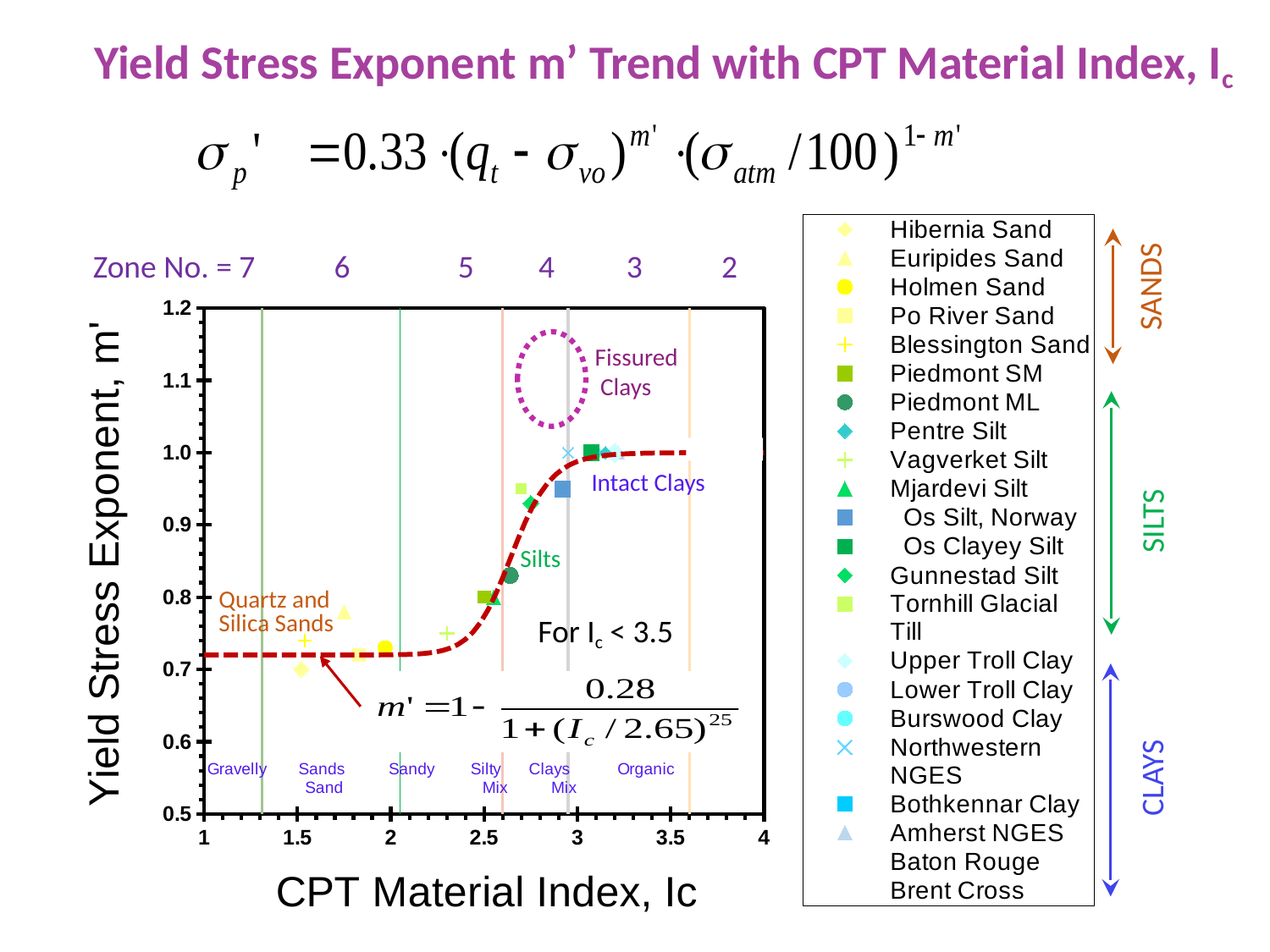
Is the value of m' for Hibernia Sand greater or less than 0.8? less Does the yield stress exponent m' generally rise or fall as the CPT Material Index Ic increases along the x axis? Rise Into how many material groups (shown by the arrows beside the legend) are the legend entries divided? 3 Is the value of m' for Piedmont ML greater or less than 0.9? less Is the value of m' for Holmen Sand greater or less than 0.8? less How many zone numbers are labelled above the chart? 6 Which has a larger value of m': Os Clayey Silt or Hibernia Sand? Os Clayey Silt What is the label of the x axis of the chart? CPT Material Index, Ic What kind of chart is shown on the slide? Scatter chart What is the label of the y axis of the chart? Yield Stress Exponent, m'